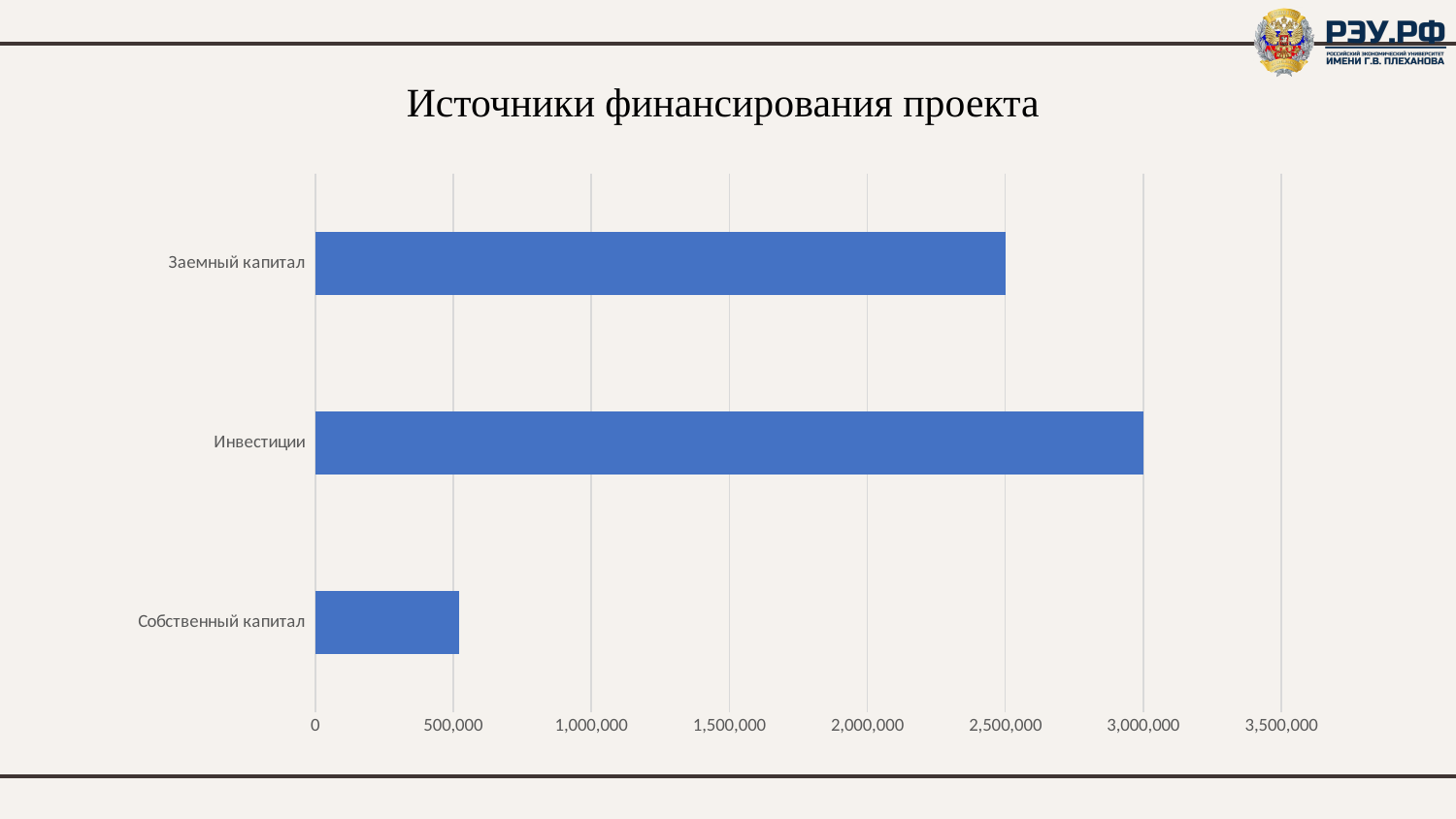
What colour are the bars in the chart? Blue What kind of chart is shown on the slide? Bar chart Is the value for Собственный капитал greater or less than 1,000,000? less Is the value for Инвестиции greater or less than 2,000,000? greater What is the title of the chart? Источники финансирования проекта How many categories are shown in the chart? 3 What is the value for Инвестиции? 3,000,000 What is the value for Заемный капитал? 2,500,000 Which category has the highest value? Инвестиции Which is larger, the value for Заемный капитал or the value for Собственный капитал? Заемный капитал Which category has the lowest value? Собственный капитал What is the difference between the values for Инвестиции and Заемный капитал? 500,000